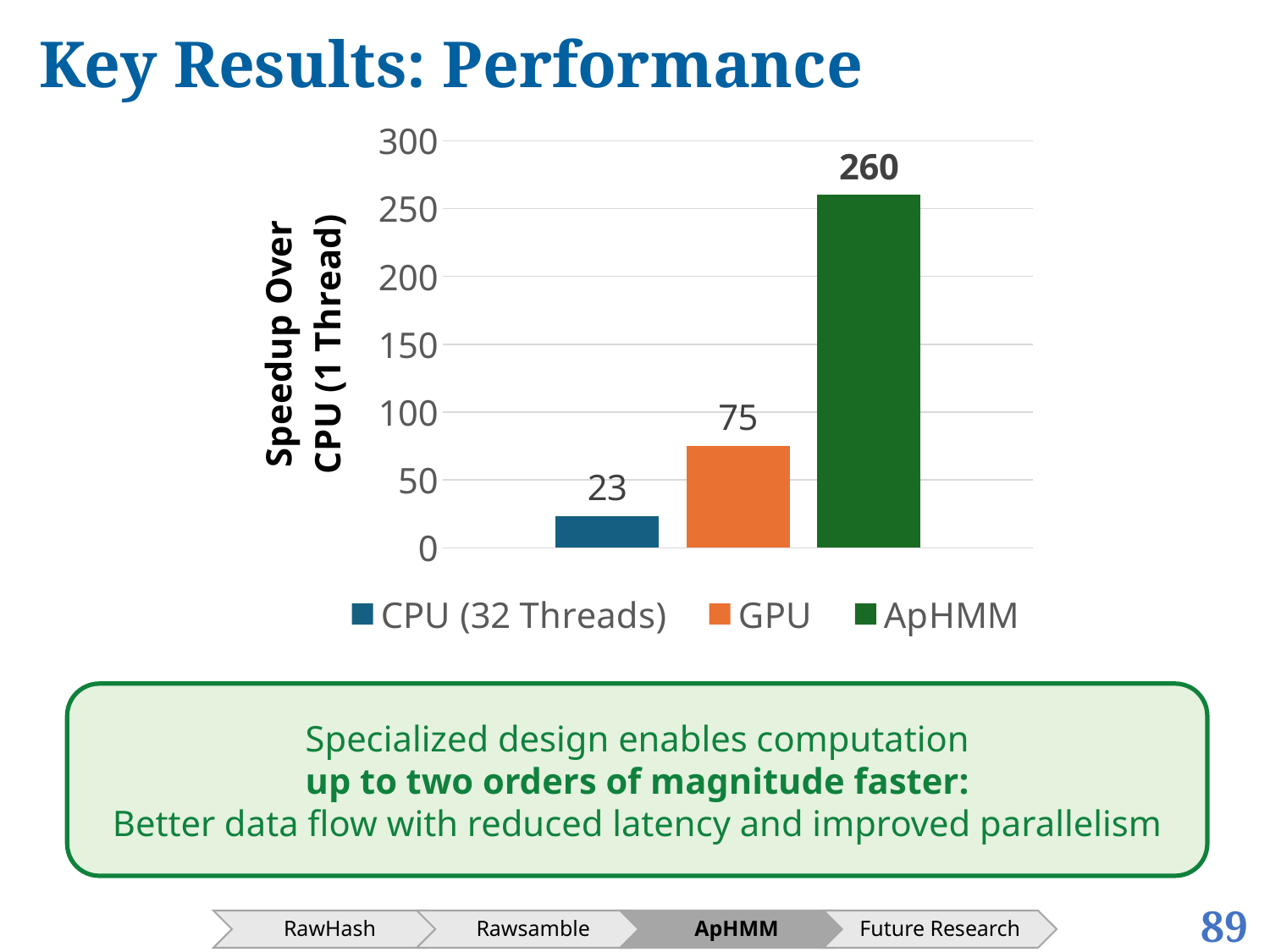
What is the speedup over CPU (1 thread) for ApHMM? 260 Which series has the lowest speedup? CPU (32 Threads) Is the speedup for ApHMM greater or less than 250? greater What is the speedup over CPU (1 thread) for CPU (32 Threads)? 23 Which series has the highest speedup? ApHMM What is the difference in speedup between ApHMM and GPU? 185 What kind of chart is shown on the slide? bar chart Which has a larger speedup, GPU or CPU (32 Threads)? GPU What is the speedup over CPU (1 thread) for GPU? 75 What is the label of the vertical axis? Speedup Over CPU (1 Thread) What is the difference in speedup between GPU and CPU (32 Threads)? 52 How many series does the legend list? 3